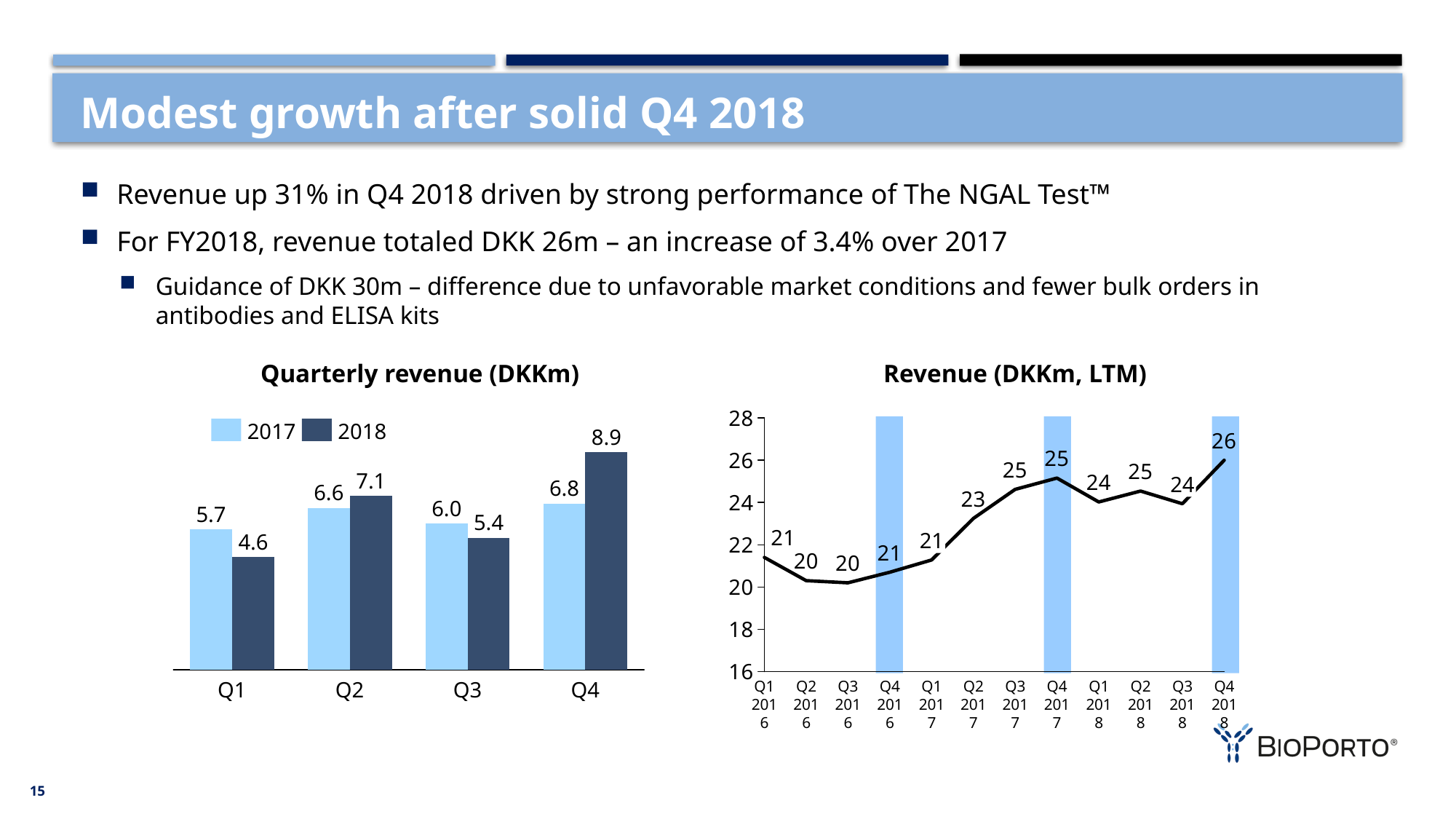
In the 'Quarterly revenue (DKKm)' chart, what is the difference between the 2018 and 2017 values for Q4? 2.1 In the 'Quarterly revenue (DKKm)' chart, what is the value for Q4 in 2018? 8.9 In the 'Quarterly revenue (DKKm)' chart, which quarter has the highest 2017 value? Q4 In the 'Quarterly revenue (DKKm)' chart, which is larger for Q3: the 2017 value or the 2018 value? 2017 What kind of chart is the 'Quarterly revenue (DKKm)' chart? Bar chart In the 'Revenue (DKKm, LTM)' chart, what is the value for Q4 2018? 26 How many series does the legend of the 'Quarterly revenue (DKKm)' chart list? 2 In the 'Quarterly revenue (DKKm)' chart, what is the value for Q1 in 2017? 5.7 In the 'Revenue (DKKm, LTM)' chart, what is the difference between the values for Q4 2018 and Q1 2016? 5 In the 'Revenue (DKKm, LTM)' chart, what is the value for Q3 2016? 20 In the 'Quarterly revenue (DKKm)' chart, which quarter has the lowest 2018 value? Q1 How many data points are plotted in the 'Revenue (DKKm, LTM)' chart? 12